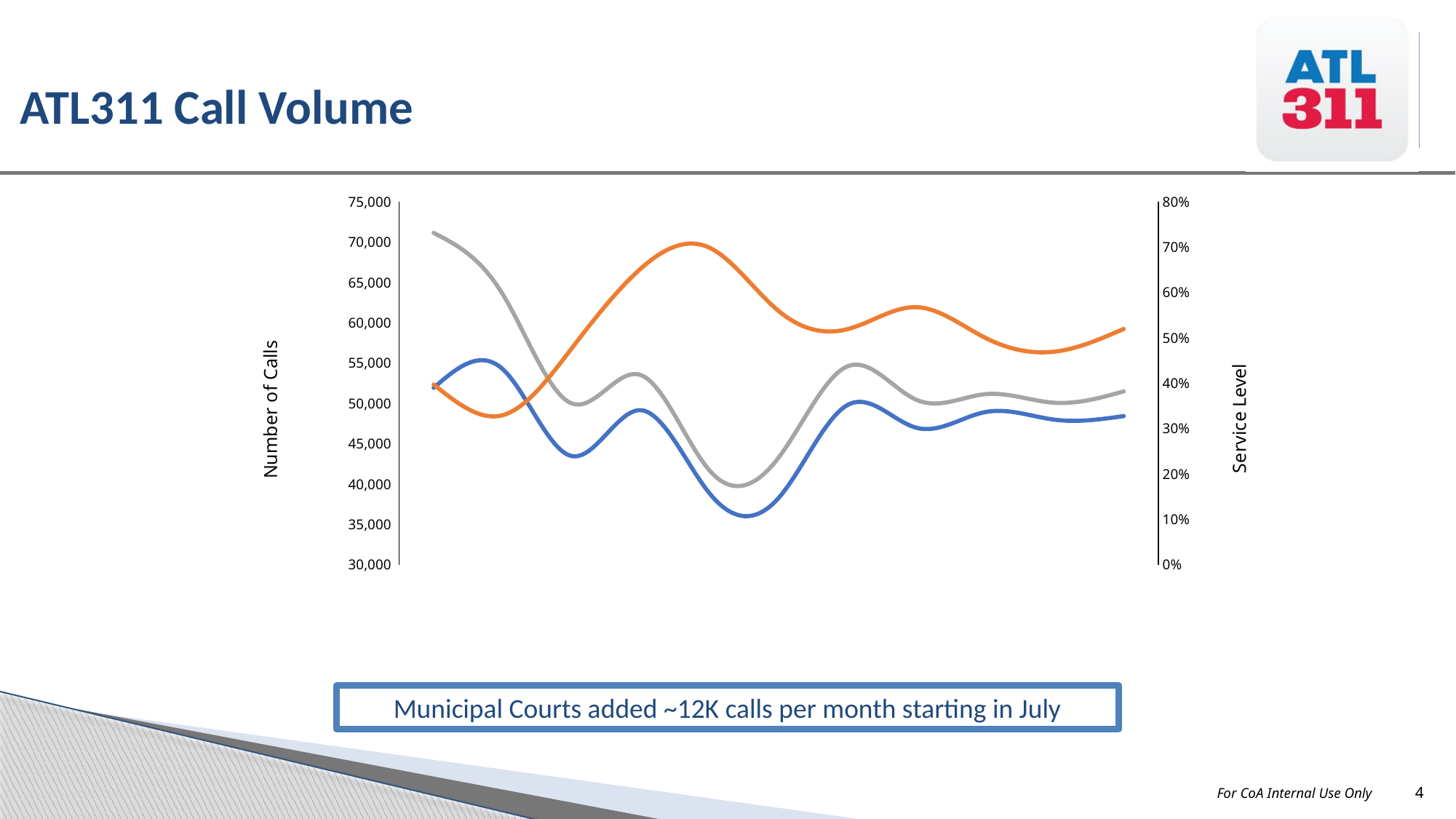
Does the gray line overall rise or fall from its first point to its last point? fall At the right end of the chart, which line is higher, the gray line or the blue line? gray line What kind of chart is shown on the slide? line chart What is the title of the slide containing the chart? ATL311 Call Volume What is the label of the right-hand vertical axis? Service Level Is the starting value of the orange line greater or less than 50%? less Is the highest point of the orange line greater or less than 60%? greater Is the starting value of the gray line greater or less than 65,000? greater Which line reaches the lowest point on the chart? blue line Does the orange line overall rise or fall from its first point to its last point? rise How many lines are plotted on the chart? 3